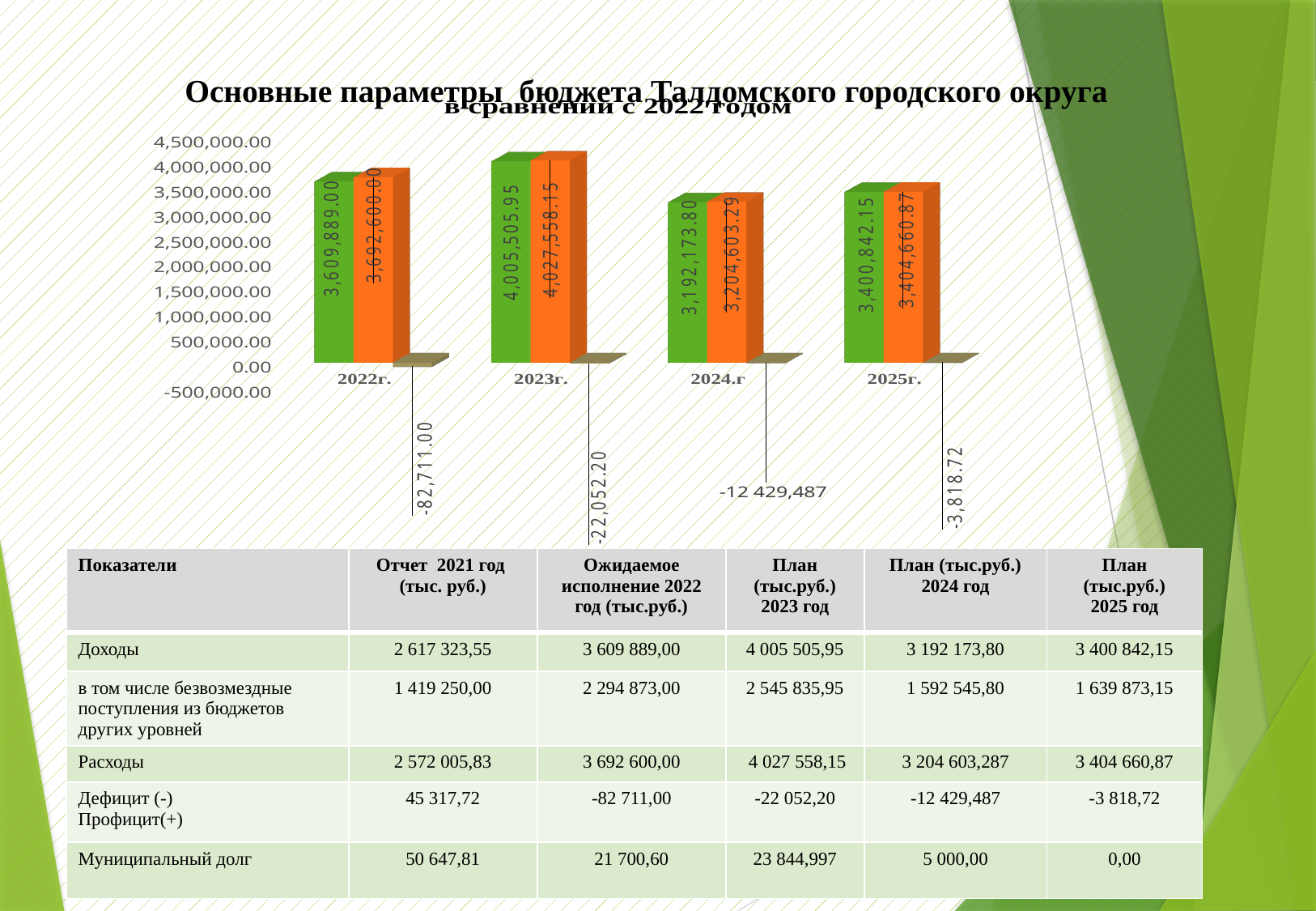
What negative value is printed below the 2025г. category? -3,818.72 Which category has the highest green bar? 2023г. What is the value printed on the orange bar for 2022г.? 3,692,600.00 What is the value printed on the green bar for 2023г.? 4,005,505.95 How many year categories are shown on the x axis of the chart? 4 What is the value printed on the green bar for 2024.г? 3,192,173.80 What negative value is printed below the 2022г. category? -82,711.00 What is the value printed on the orange bar for 2025г.? 3,404,660.87 What kind of chart is shown on the slide? bar chart Which is larger for 2023г., the green bar or the orange bar? the orange bar Which category has the lowest orange bar? 2024.г Is the green bar for 2022г. greater or less than 3,500,000.00? greater